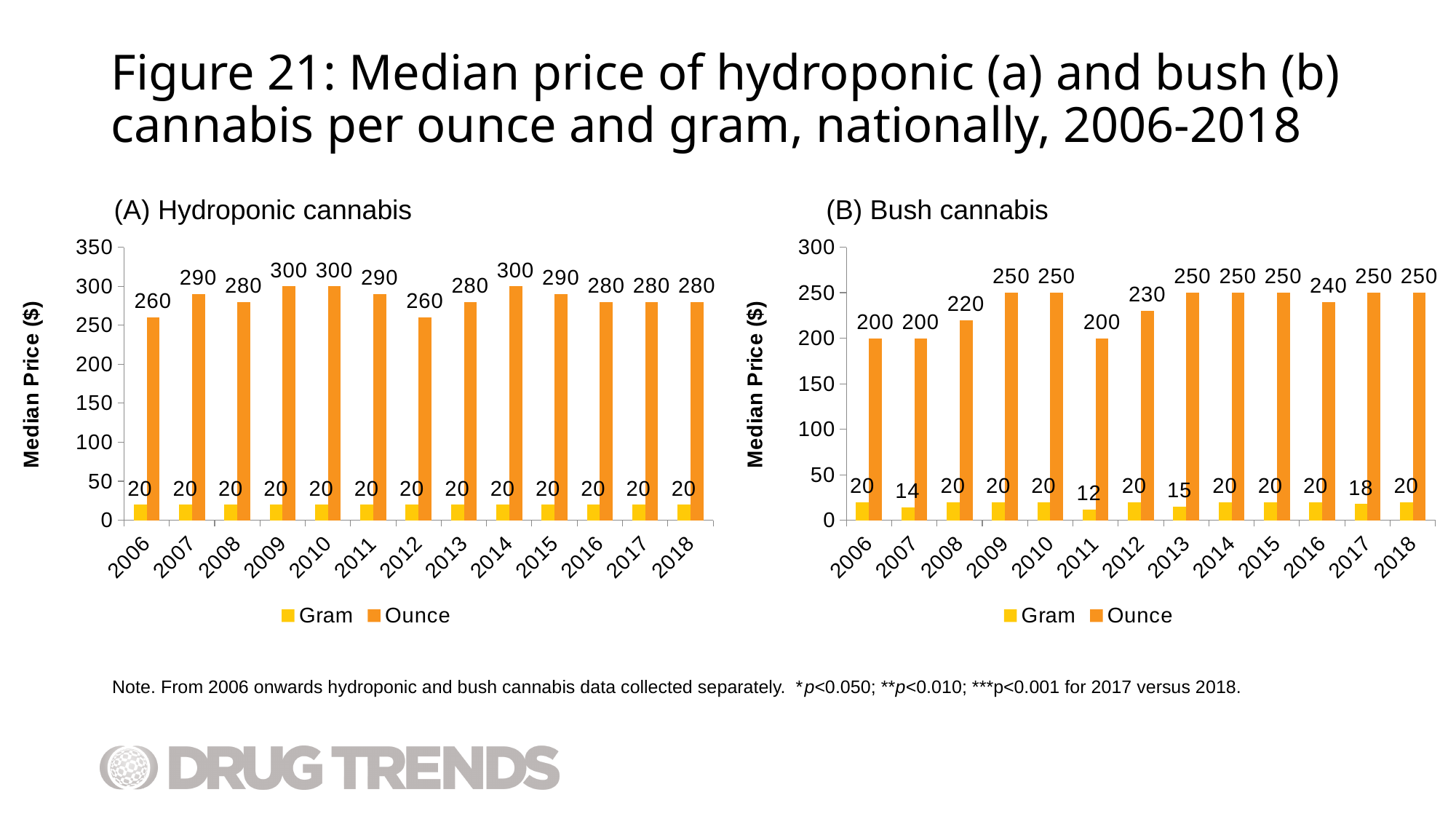
Which is larger: the median ounce price for hydroponic cannabis in 2018 or for bush cannabis in 2018? Hydroponic cannabis in 2018 How many years are shown on the x axis of the (B) Bush cannabis chart? 13 In the (B) Bush cannabis chart, what is the median price per ounce in 2016? 240 In the (A) Hydroponic cannabis chart, what is the median price per ounce in 2012? 260 How many series does the legend of the (A) Hydroponic cannabis chart list? 2 What is the y-axis label of the (A) Hydroponic cannabis chart? Median Price ($) In the (B) Bush cannabis chart, what is the median price per gram in 2011? 12 What type of chart is the (B) Bush cannabis chart? Bar chart In the (A) Hydroponic cannabis chart, what is the difference between the median ounce price in 2014 and in 2012? 40 In the (A) Hydroponic cannabis chart, which years have the highest median price per ounce? 2009, 2010 and 2014 In the (B) Bush cannabis chart, what is the difference between the median ounce price in 2009 and in 2006? 50 In the (B) Bush cannabis chart, which year has the lowest median price per gram? 2011